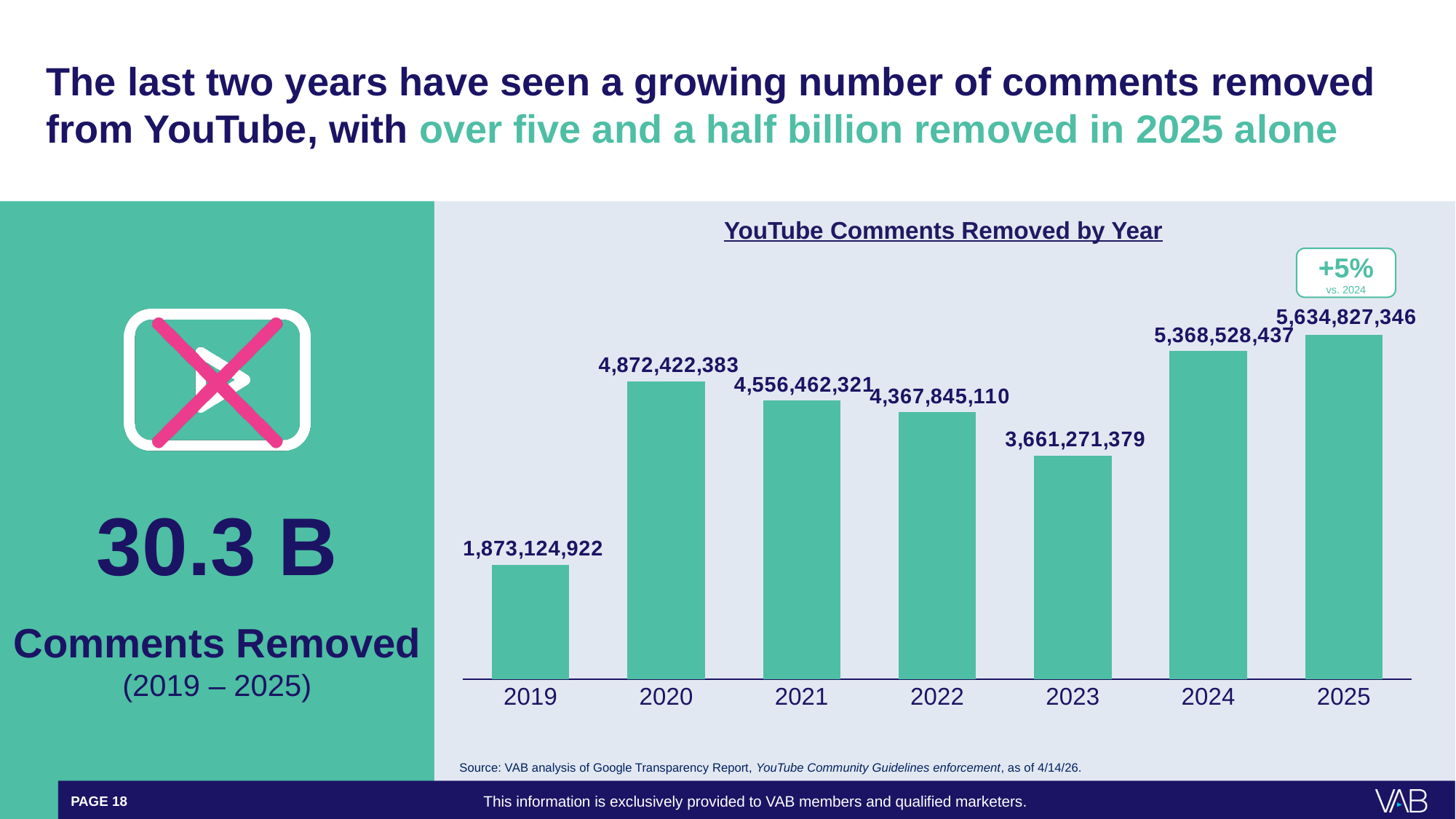
Which year had the highest number of YouTube comments removed? 2025 What is the value shown for 2025 in the YouTube Comments Removed by Year chart? 5,634,827,346 How many YouTube comments were removed in 2023? 3,661,271,379 How many YouTube comments were removed in 2019? 1,873,124,922 Which year had the lowest number of YouTube comments removed? 2019 How many more comments were removed in 2025 than in 2024? 266,298,909 Which year had more comments removed, 2020 or 2021? 2020 How many years are shown in the YouTube Comments Removed by Year chart? 7 What is the difference between the number of comments removed in 2022 and in 2023? 706,573,731 What percentage change versus 2024 is annotated above the 2025 bar? +5% What type of chart is used to show YouTube Comments Removed by Year? Bar chart Did the number of comments removed rise or fall from 2020 to 2023? Fall